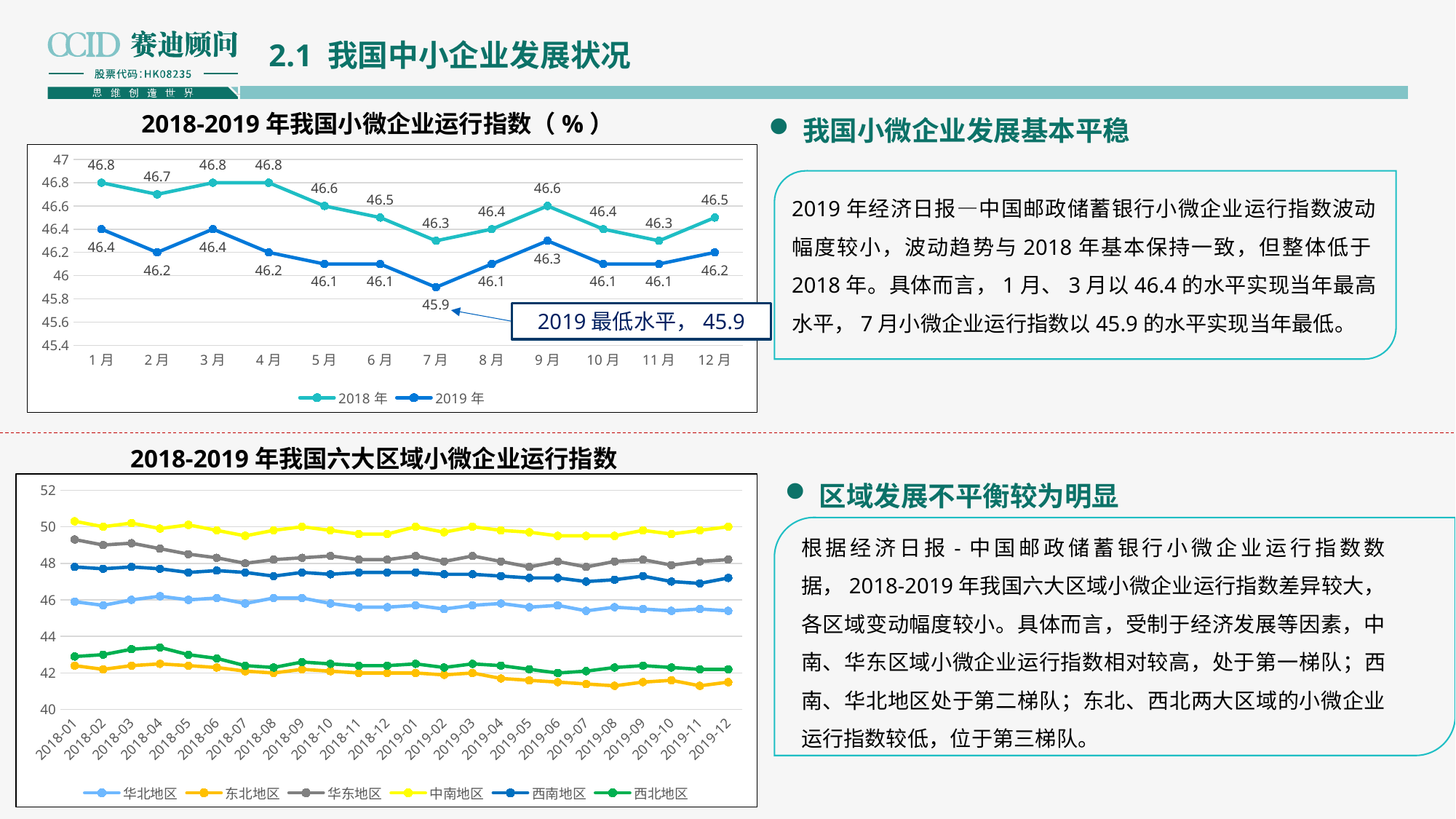
In the top chart, which month has the lowest value for the 2019 年 series? 7 月 In the bottom chart, which region has the highest values across the period? 中南地区 In the top chart, which is larger in 9 月: the 2018 年 value or the 2019 年 value? 2018 年 In the bottom chart, which region has the lowest values across the period? 东北地区 What kind of chart is the bottom chart (2018-2019 年我国六大区域小微企业运行指数)? Line chart In the top chart, how many months are plotted along the x axis? 12 In the top chart (2018-2019 年我国小微企业运行指数), what is the value for 2019 年 in 7 月? 45.9 In the top chart, how many series does the legend list? 2 In the bottom chart, is the value for 华东地区 in 2018-01 greater or less than 48? greater In the top chart, what is the value for 2018 年 in 2 月? 46.7 In the bottom chart, how many series does the legend list? 6 In the top chart, what is the difference between the 2018 年 and 2019 年 values in 12 月? 0.3